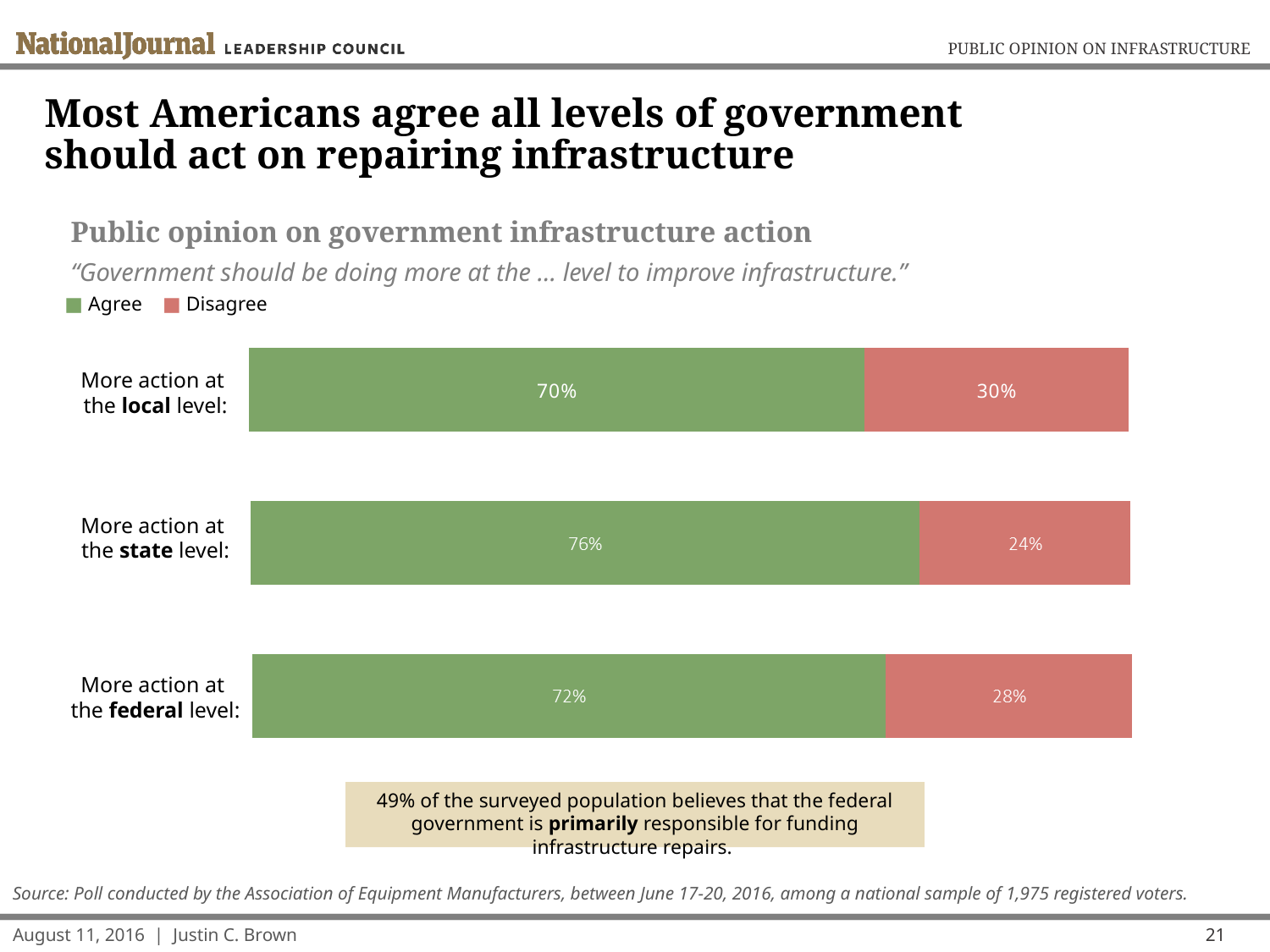
What kind of chart is shown on the slide? Stacked bar chart Which level of government has the highest Agree percentage? State What percentage agree that government should be doing more at the local level to improve infrastructure? 70% What is the total of the Agree and Disagree segments for the federal level bar? 100% What percentage disagree that government should be doing more at the state level? 24% Which level of government has the lowest Agree percentage? Local How many series does the legend list? 2 What is the Disagree value for more action at the local level? 30% What is the difference between the Agree percentages for the state level and the local level? 6 percentage points Which is larger: the Disagree value for the federal level or the Disagree value for the state level? Federal level What is the Agree value for more action at the federal level? 72% How many levels of government are shown in the chart? 3